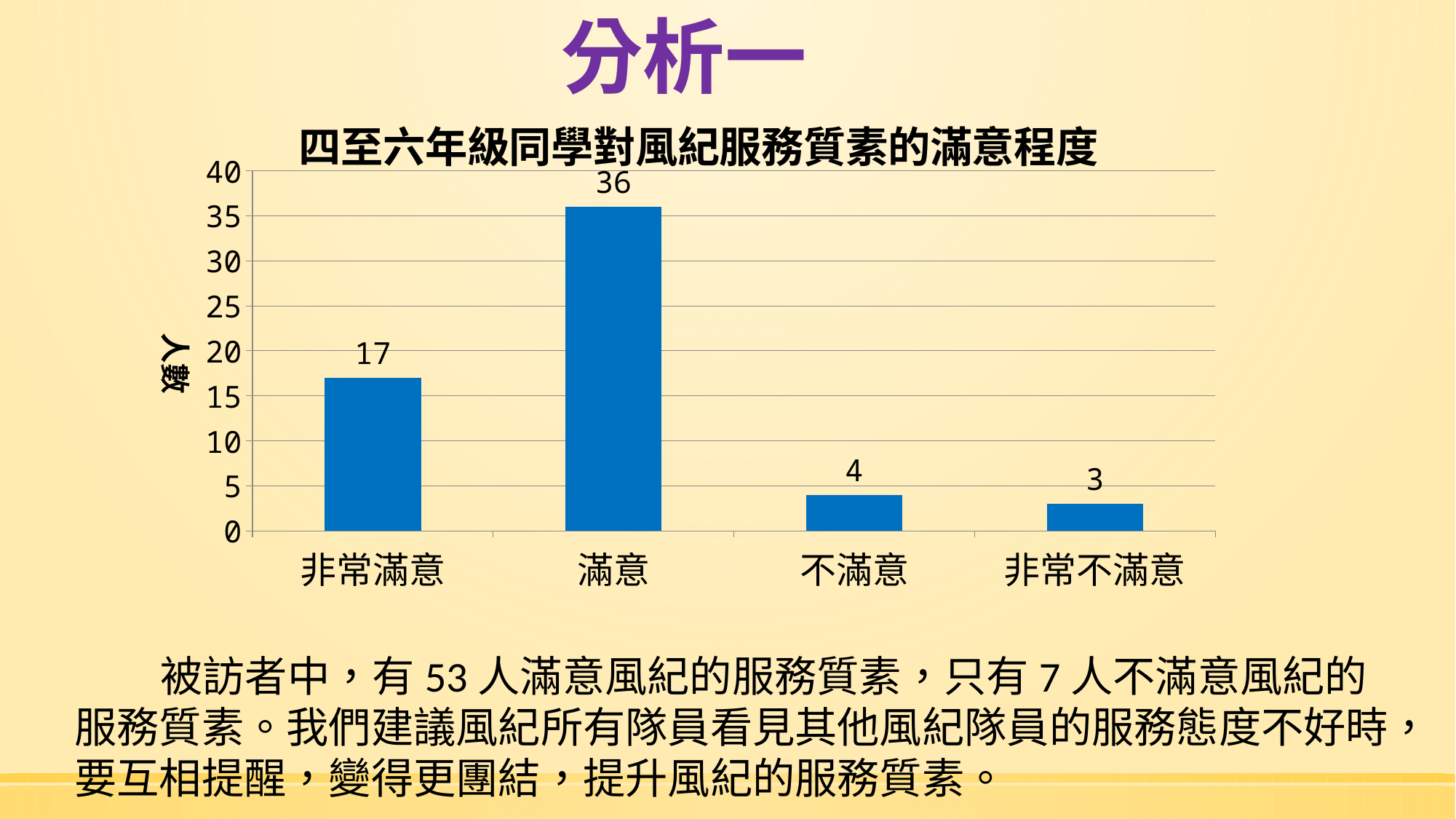
What is the value for 非常不滿意? 3 What is the difference between the values for 滿意 and 非常滿意? 19 Which is larger, the value for 非常滿意 or the value for 不滿意? 非常滿意 Which category has the highest value? 滿意 Which category has the lowest value? 非常不滿意 What kind of chart is shown on the slide? bar chart Is the value for 滿意 greater or less than 30? greater What is the value for 滿意? 36 How many categories are shown on the x axis? 4 What is the value for 非常滿意? 17 What is the value for 不滿意? 4 What is the title of the chart? 四至六年級同學對風紀服務質素的滿意程度